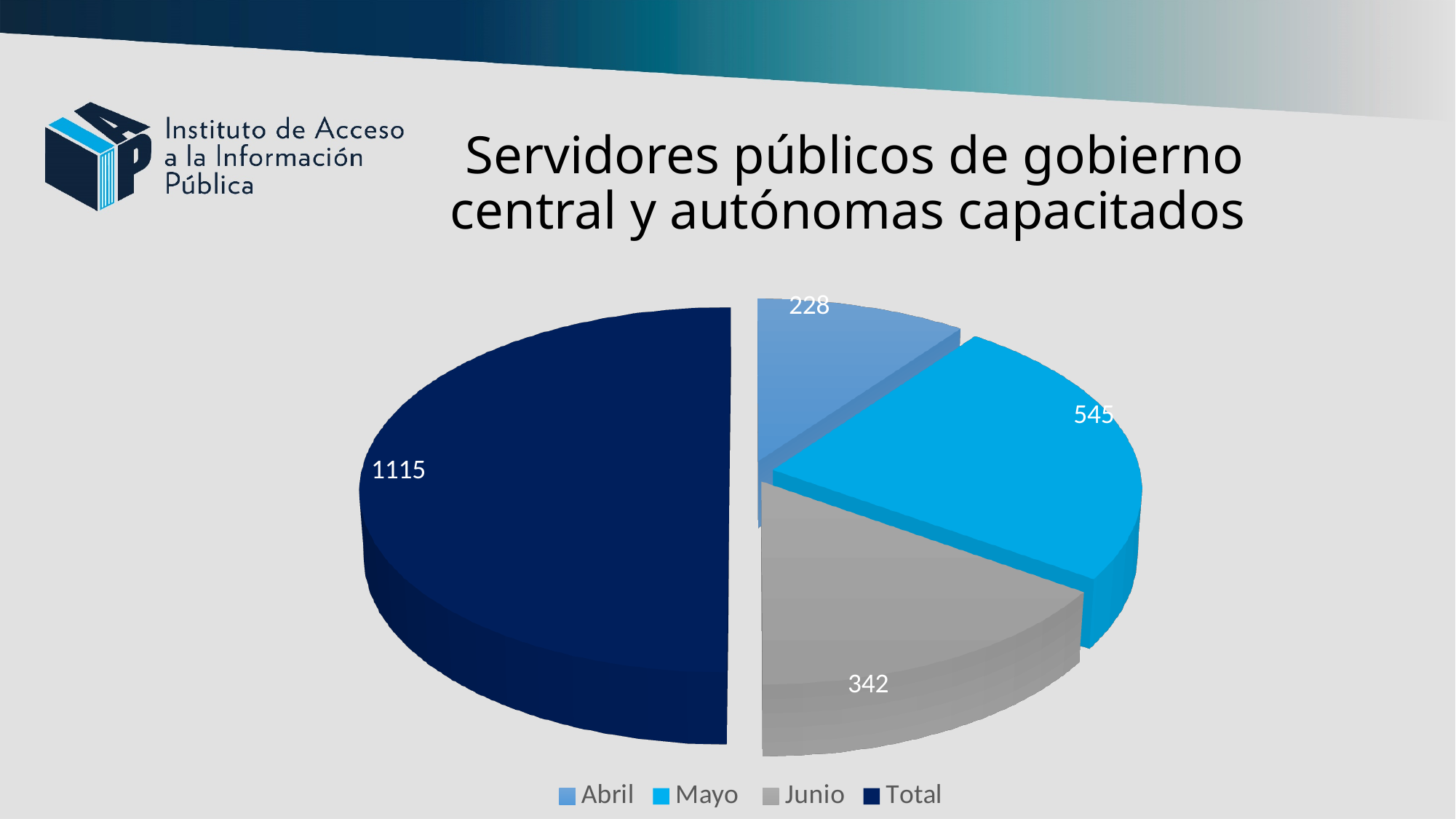
Which slice has the largest value? Total How many entries does the legend list? 4 What is the difference between the Mayo and Abril values? 317 Which of the three months, Abril, Mayo or Junio, has the highest value? Mayo What is the value of the Total slice? 1115 What is the value of the Junio slice? 342 Which is larger, the Junio value or the Abril value? Junio Which slice has the smallest value? Abril What is the value of the Abril slice? 228 What is the title of the chart? Servidores públicos de gobierno central y autónomas capacitados What is the value of the Mayo slice? 545 What type of chart is shown on the slide? Pie chart